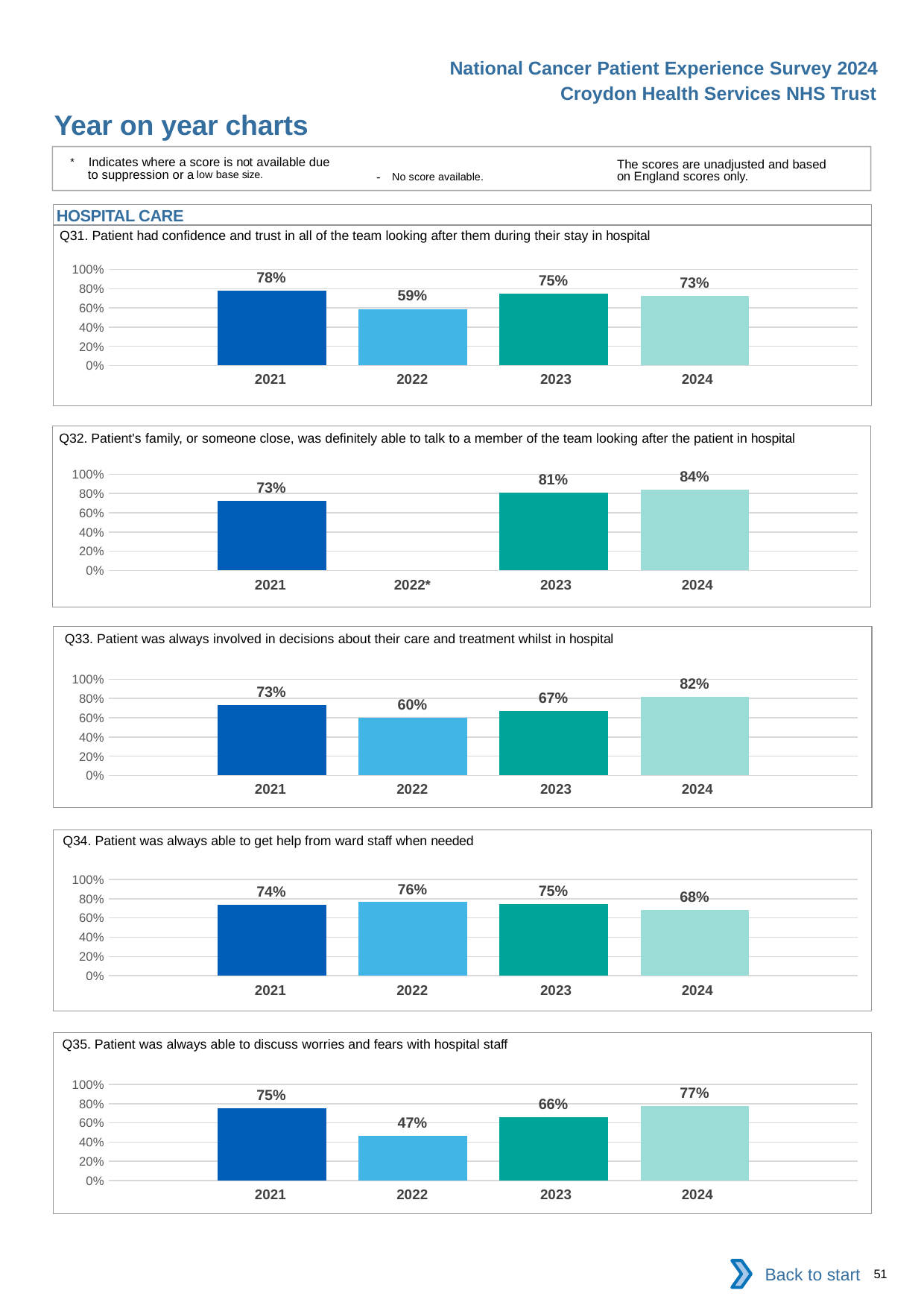
In the Q35 chart, what is the value for 2022? 47% In the Q34 chart, which is larger, the value for 2022 or the value for 2024? 2022 In the Q31 chart, which year has the highest value? 2021 In the Q32 chart, which year has no bar plotted? 2022* In the Q31 chart, what is the value for 2022? 59% In the Q34 chart, what is the difference between the 2022 and 2024 values? 8% What type of chart is the Q35 chart? Bar chart In the Q33 chart, what is the value for 2024? 82% In the Q32 chart, what is the value for 2024? 84% In the Q32 chart, what is the difference between the 2024 and 2021 values? 11% In the Q35 chart, how many years are shown on the x axis? 4 In the Q33 chart, which year has the lowest value? 2022